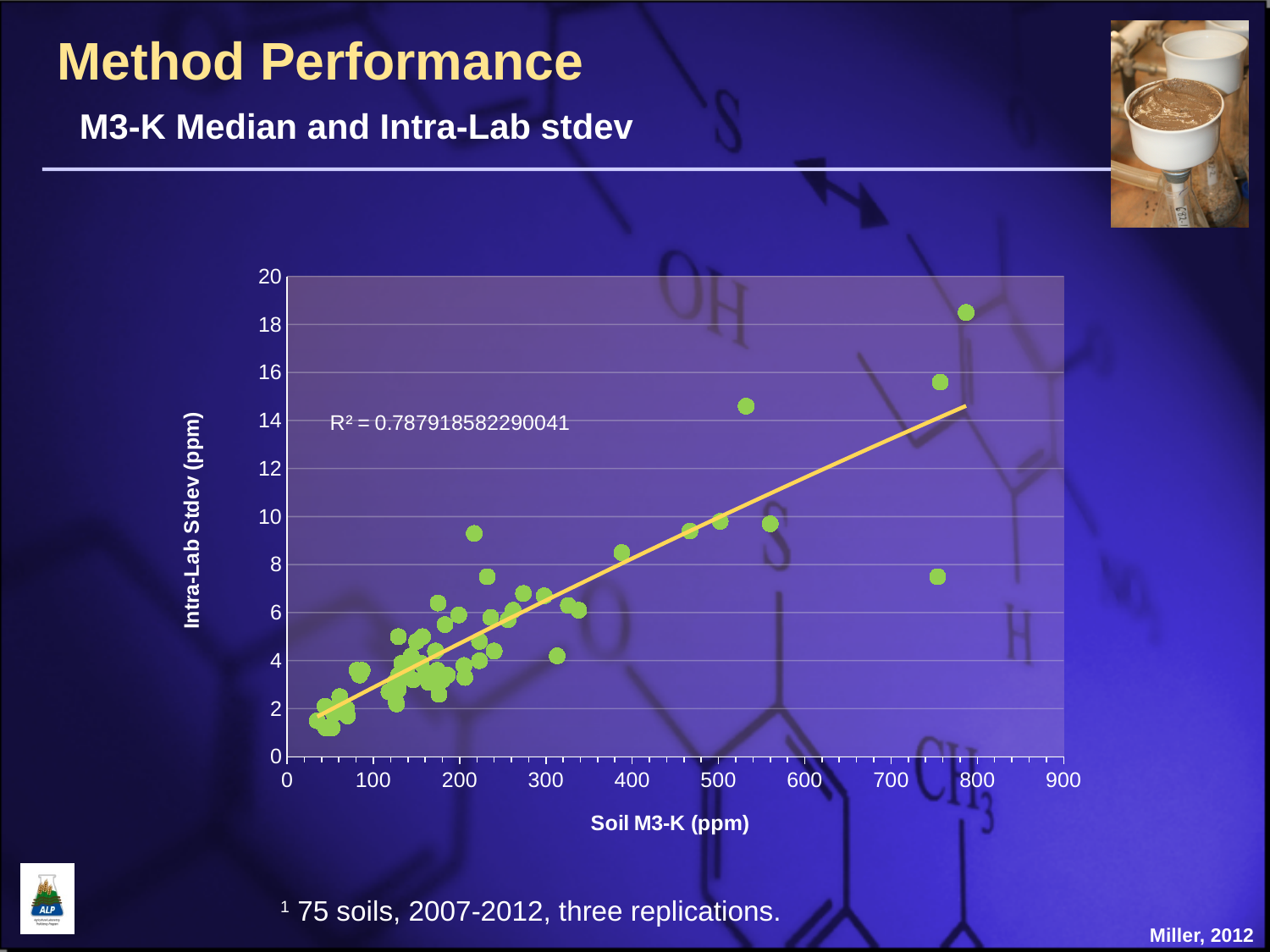
What is the maximum value shown on the y axis? 20 What kind of chart is shown on the slide? Scatter chart Is the intra-lab stdev for the point near 530 ppm soil M3-K greater or less than 12 ppm? greater What is the label of the y axis? Intra-Lab Stdev (ppm) Does the intra-lab stdev generally rise or fall as soil M3-K increases? Rise What is the label of the x axis? Soil M3-K (ppm) Is the soil M3-K value of the point with the highest intra-lab stdev greater or less than 700 ppm? greater Is the highest intra-lab stdev value plotted greater or less than 18 ppm? greater What is the R² value printed on the chart? 0.787918582290041 What is the maximum value shown on the x axis? 900